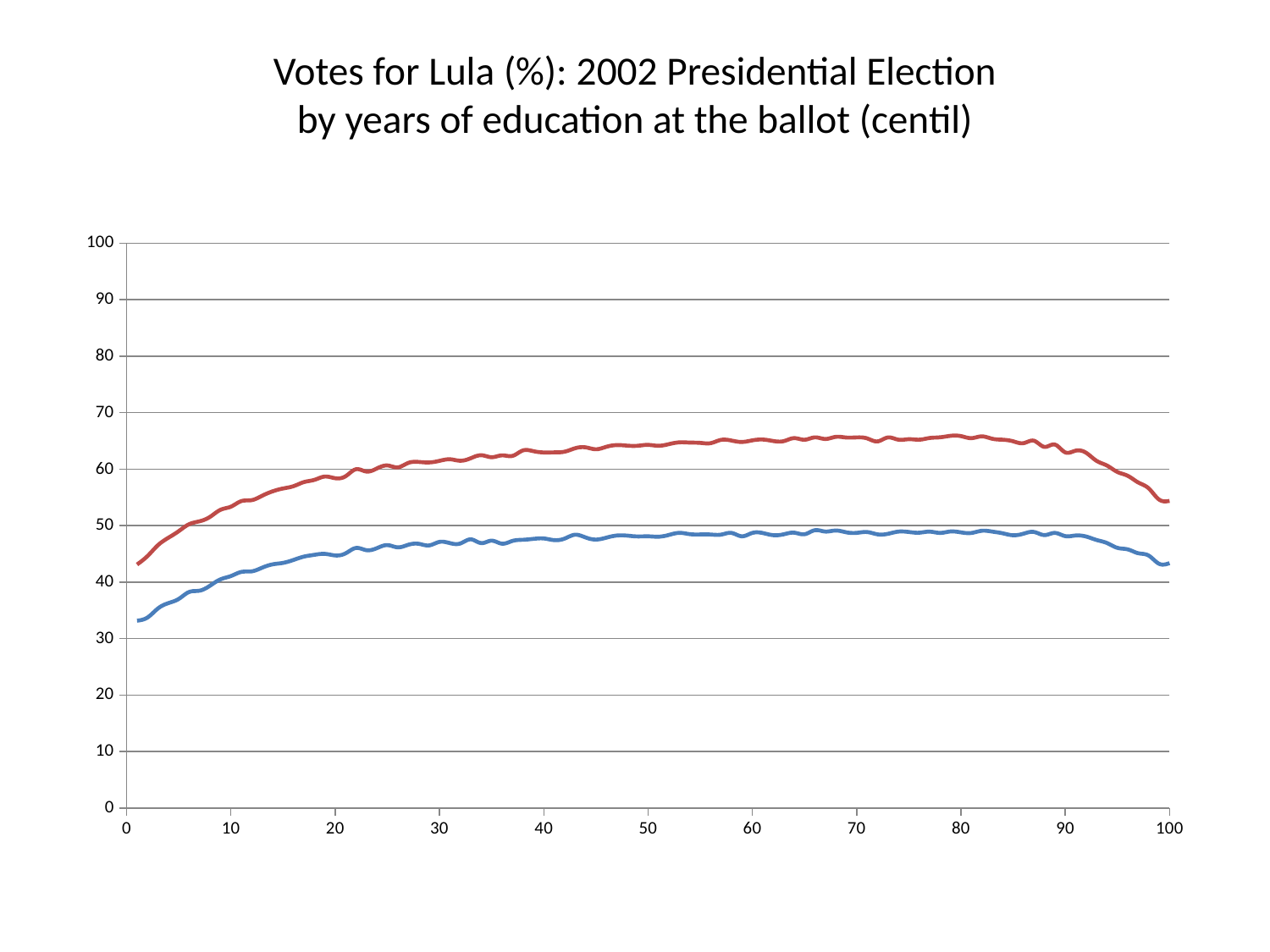
Does the blue line rise or fall between x = 0 and x = 20? rise Is the value of the red line at x = 80 greater or less than 70? less What is the title of the chart on the slide? Votes for Lula (%): 2002 Presidential Election by years of education at the ballot (centil) Does the red line rise or fall between x = 90 and x = 100? fall Is the value of the blue line at x = 1 greater or less than 40? less At x = 50, which line has the higher value, the red line or the blue line? the red line Is the value of the blue line at x = 50 greater or less than 50? less What kind of chart is shown on the slide? line chart How many lines are plotted on the chart? 2 What is the highest value shown on the vertical axis? 100